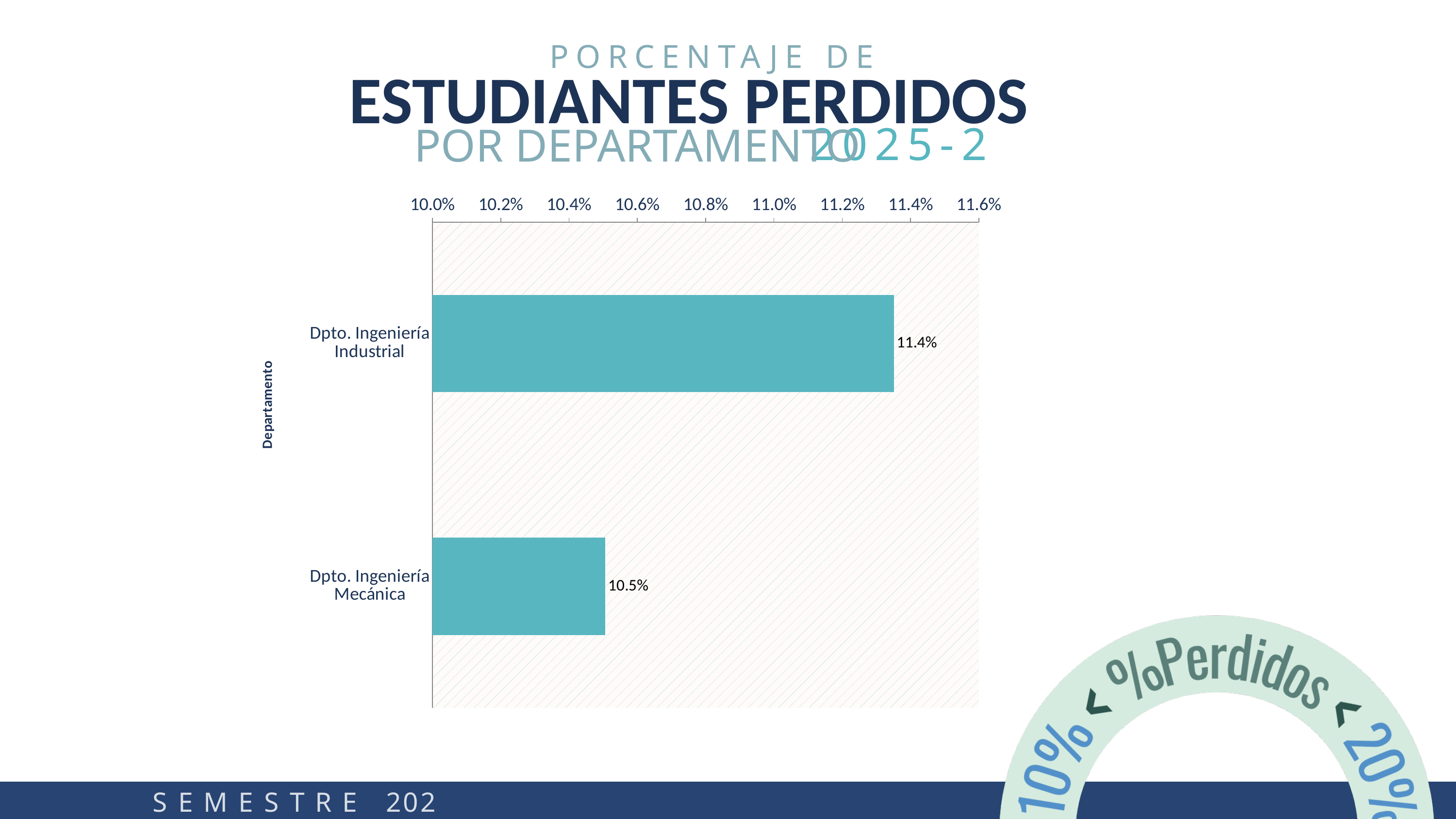
Is the value for Dpto. Ingeniería Mecánica greater or less than 11.0%? less What is the value for Dpto. Ingeniería Industrial? 11.4% What kind of chart is shown on the slide? bar chart How many departments are shown in the chart? 2 Which department has the highest percentage of lost students? Dpto. Ingeniería Industrial Which is larger, the value for Dpto. Ingeniería Industrial or Dpto. Ingeniería Mecánica? Dpto. Ingeniería Industrial What is the highest value shown on the horizontal axis of the chart? 11.6% What is the label of the vertical axis of the chart? Departamento Is the value for Dpto. Ingeniería Industrial greater or less than 11.0%? greater What is the value for Dpto. Ingeniería Mecánica? 10.5% Which department has the lowest percentage of lost students? Dpto. Ingeniería Mecánica What is the difference between the values for Dpto. Ingeniería Industrial and Dpto. Ingeniería Mecánica? 0.9%